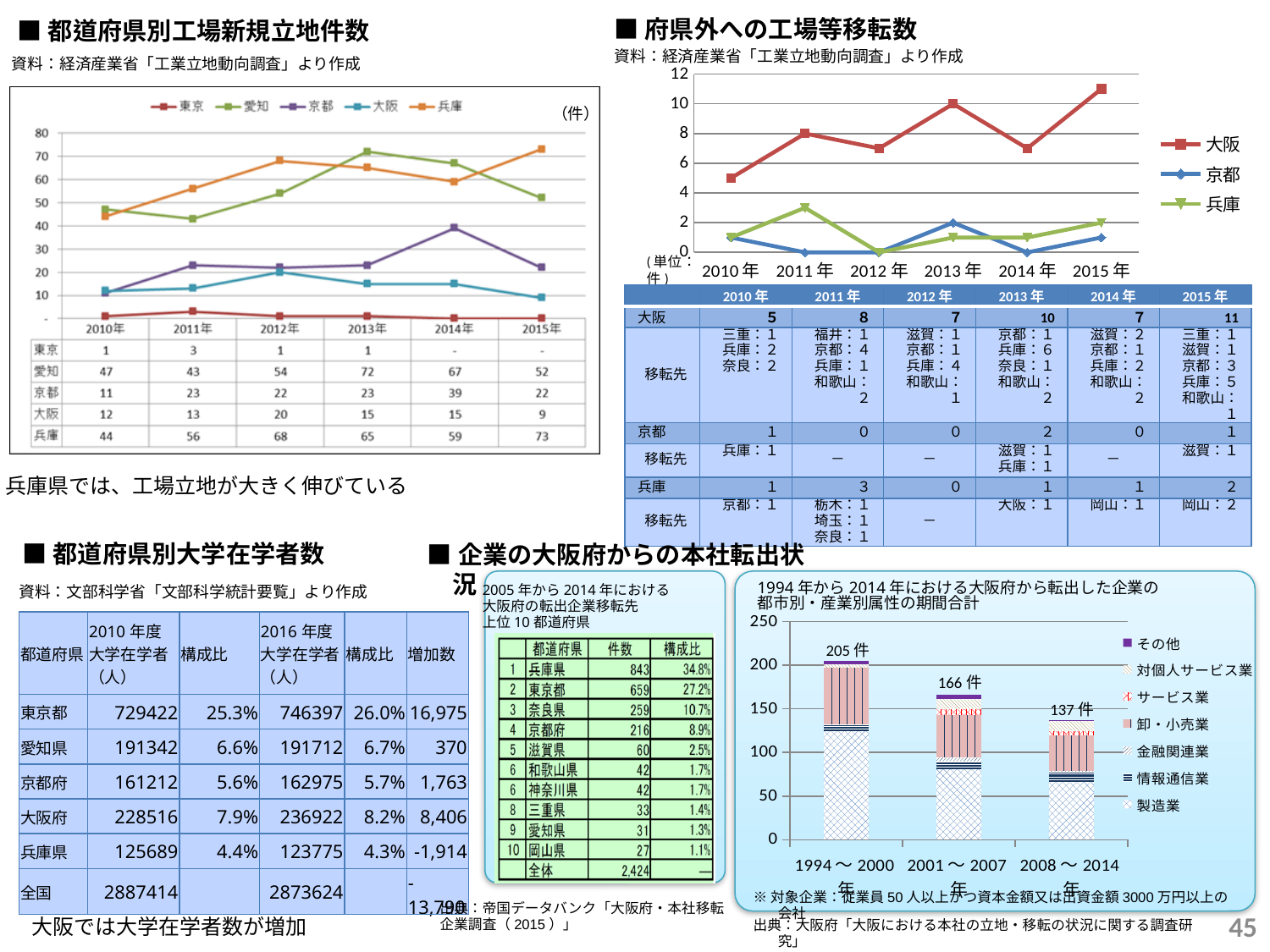
In the 都道府県別工場新規立地件数 chart, what is the difference between the 愛知 values for 2013年 and 2012年? 18 How many series does the legend of the 企業の大阪府からの本社転出状況 bar chart list? 7 What kind of chart is the 都道府県別工場新規立地件数 chart? Line chart In the 都道府県別工場新規立地件数 chart, what is the value for 兵庫 in 2015年? 73 How many years are shown on the x axis of the 府県外への工場等移転数 chart? 6 In the 企業の大阪府からの本社転出状況 bar chart, do the bar totals rise or fall from 1994～2000年 to 2008～2014年? Fall In the 企業の大阪府からの本社転出状況 bar chart, what is the total for 1994～2000年? 205件 In the 都道府県別工場新規立地件数 chart, which prefecture has the highest value in 2013年? 愛知 In the 府県外への工場等移転数 chart, what is the value for 大阪 in 2015年? 11 How many series does the legend of the 都道府県別工場新規立地件数 chart list? 5 In the 府県外への工場等移転数 chart, in which year is the 大阪 value highest? 2015年 In the 府県外への工場等移転数 chart, which is larger in 2011年: 兵庫 or 京都? 兵庫